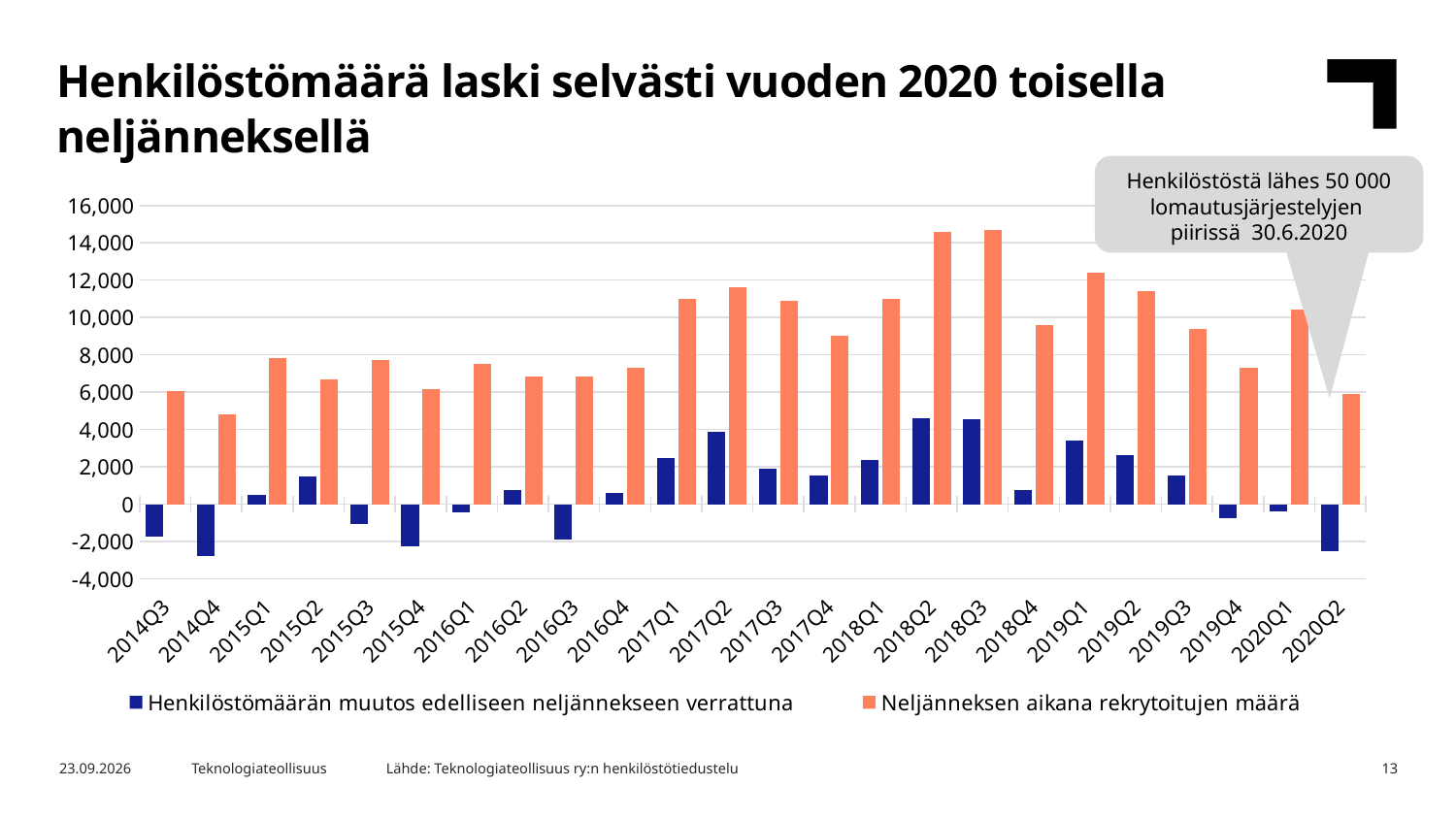
Is the value for 'Neljänneksen aikana rekrytoitujen määrä' in 2020Q1 greater or less than 10,000? greater Which quarter has the lowest value for 'Neljänneksen aikana rekrytoitujen määrä'? 2014Q4 Is the value for 'Henkilöstömäärän muutos edelliseen neljännekseen verrattuna' in 2020Q2 greater or less than -2,000? less Is the value for 'Neljänneksen aikana rekrytoitujen määrä' in 2018Q2 greater or less than 14,000? greater Which quarter has the larger value for 'Henkilöstömäärän muutos edelliseen neljännekseen verrattuna', 2017Q2 or 2017Q3? 2017Q2 How many quarters are shown on the x axis of the chart? 24 What does the callout on the chart say about the number of staff under lay-off arrangements on 30.6.2020? Henkilöstöstä lähes 50 000 lomautusjärjestelyjen piirissä What kind of chart is shown on the slide? bar chart Do the values for 'Neljänneksen aikana rekrytoitujen määrä' rise or fall from 2018Q3 to 2020Q2? fall How many series does the chart legend list? 2 Which quarter has the larger value for 'Neljänneksen aikana rekrytoitujen määrä', 2019Q1 or 2019Q2? 2019Q1